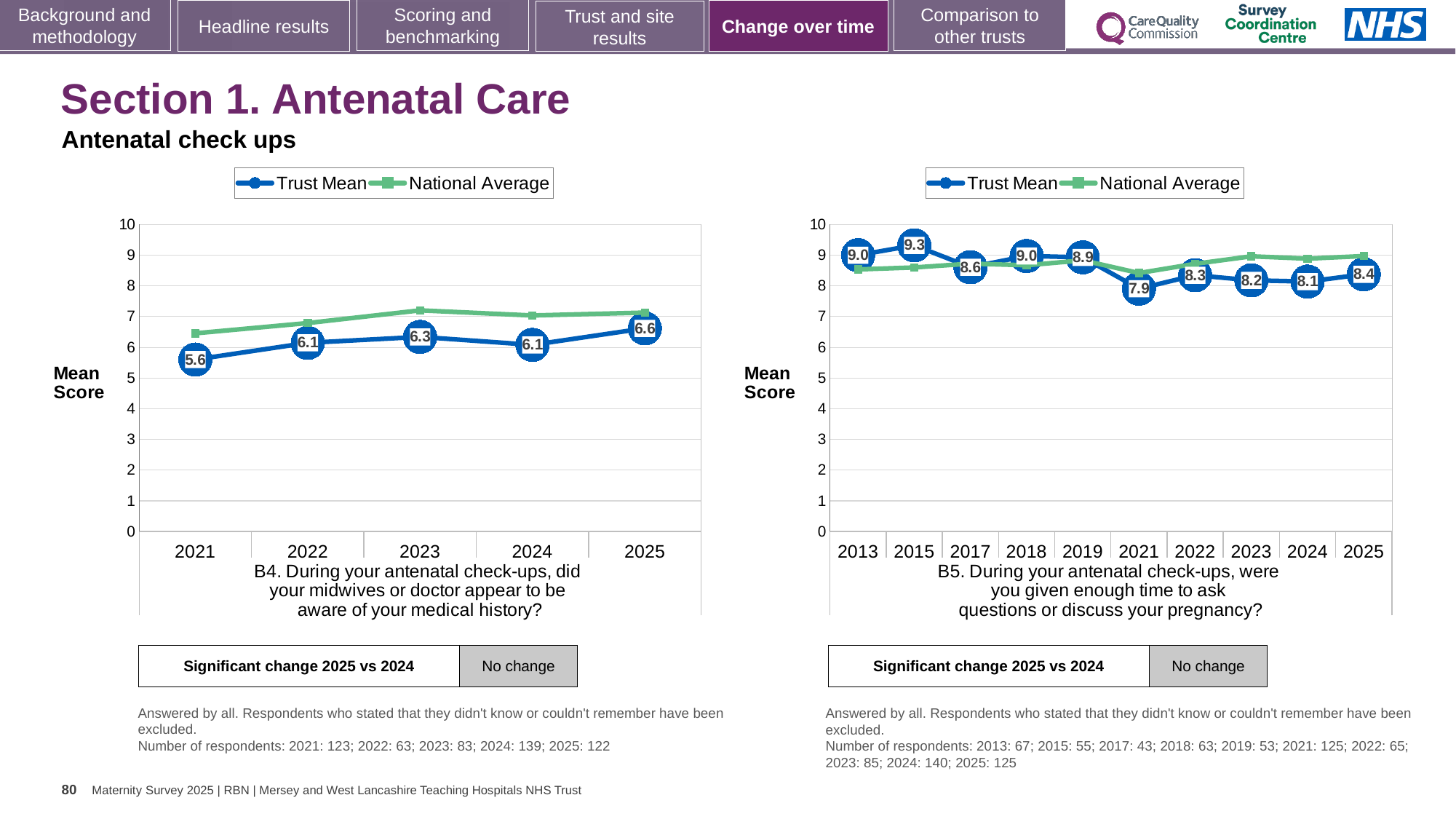
In the left chart (B4), which year has the lowest Trust Mean score? 2021 In the right chart (B5), is the Trust Mean score higher in 2013 or in 2024? 2013 In the right chart (B5), which year has the highest Trust Mean score? 2015 In the left chart (B4), what is the difference between the Trust Mean scores for 2025 and 2021? 1.0 In the left chart (B4), is the National Average for 2021 greater or less than 6? greater In the right chart (B5), what is the Trust Mean score for 2021? 7.9 In the left chart (B4), how many years are shown on the x axis? 5 In the left chart (B4), what is the Trust Mean score for 2021? 5.6 In the left chart (B4), what is the Trust Mean score for 2025? 6.6 What type of chart is the right chart (B5)? Line chart In the right chart (B5), how many series does the legend list? 2 In the right chart (B5), which year has the lowest Trust Mean score? 2021